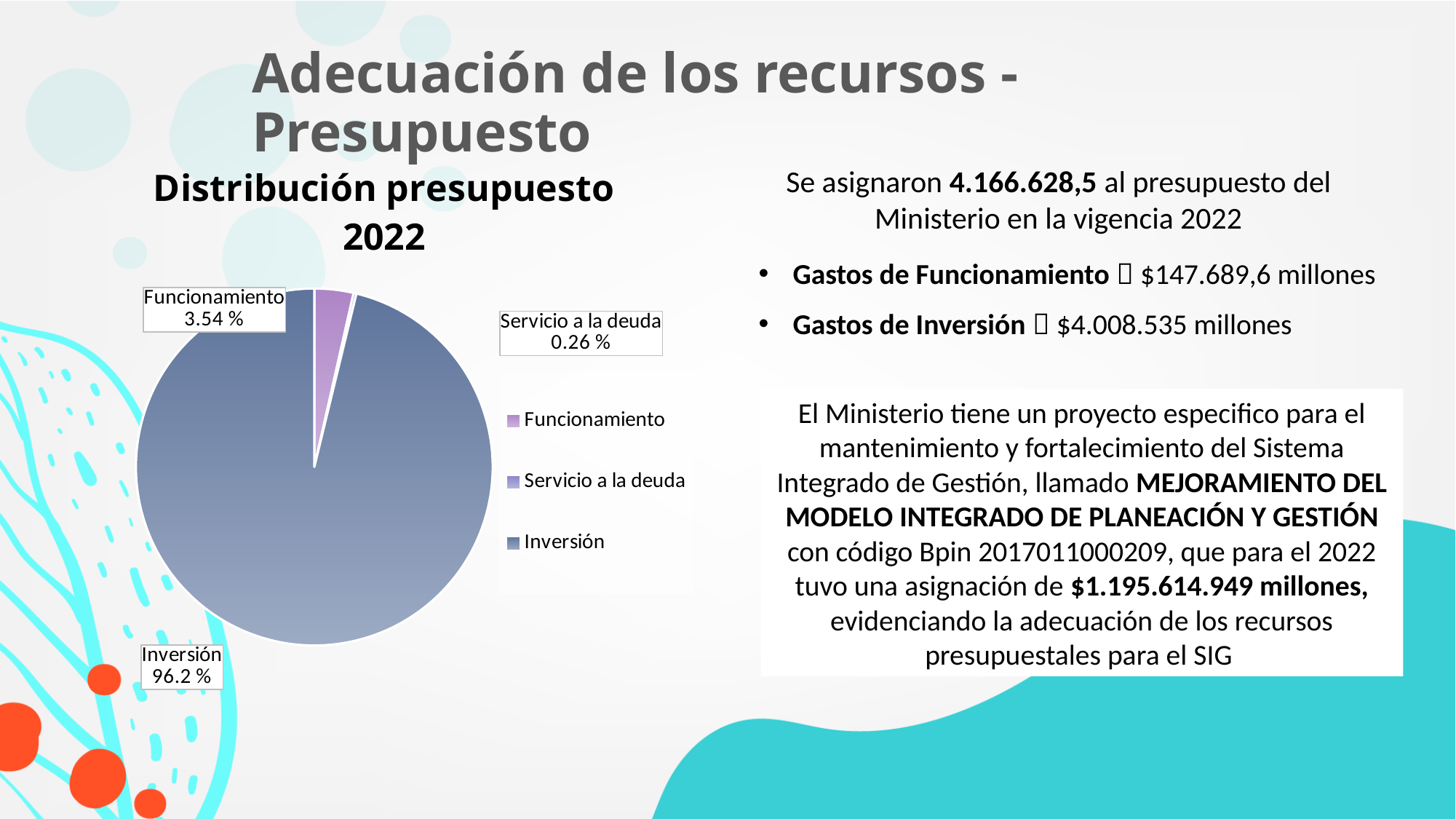
What share of the pie does Servicio a la deuda represent? 0.26 % What share of the pie does Inversión represent? 96.2 % What share of the pie does Funcionamiento represent? 3.54 % How many categories does the pie chart show? 3 What is the difference in percentage points between the Inversión share and the Funcionamiento share? 92.66 % What is the title of the chart? Distribución presupuesto 2022 Is the share for Inversión greater or less than 90 %? greater How many entries does the legend list? 3 Which category has the largest slice of the pie? Inversión Which category has the smallest slice of the pie? Servicio a la deuda Which is larger, the share for Funcionamiento or the share for Servicio a la deuda? Funcionamiento What kind of chart is shown on the slide? pie chart